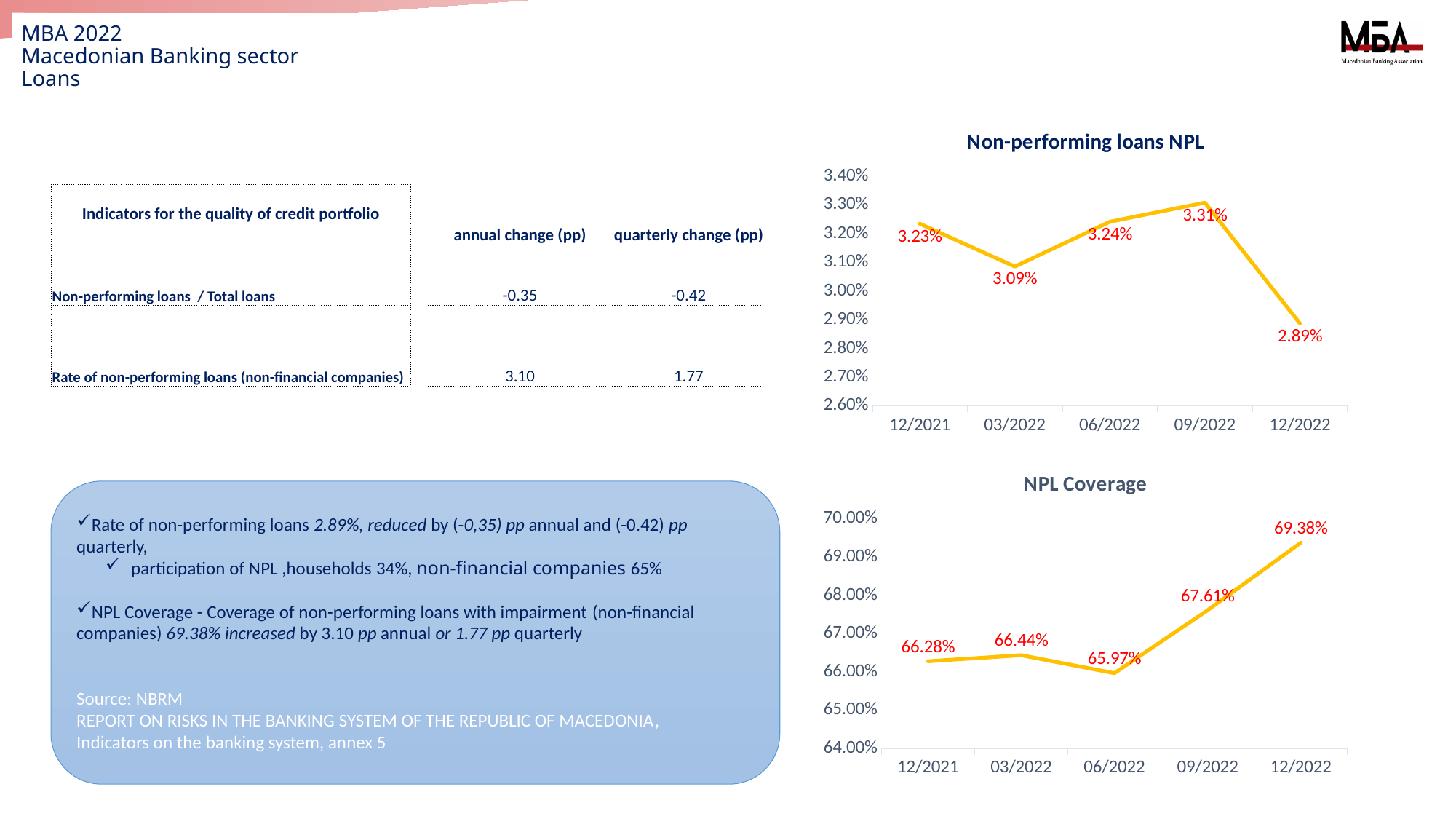
In the 'Non-performing loans NPL' chart, what is the value for 03/2022? 3.09% In the 'NPL Coverage' chart, what is the value for 09/2022? 67.61% In the 'Non-performing loans NPL' chart, how many data points are plotted? 5 In the 'Non-performing loans NPL' chart, what is the difference between the values for 09/2022 and 12/2022? 0.42 percentage points In the 'NPL Coverage' chart, what is the difference between the values for 12/2022 and 12/2021? 3.10 percentage points In the 'Non-performing loans NPL' chart, which period has the highest value? 09/2022 In the 'Non-performing loans NPL' chart, which period has the lowest value? 12/2022 What kind of chart is the 'NPL Coverage' chart? Line chart In the 'NPL Coverage' chart, which period has the lowest value? 06/2022 In the 'Non-performing loans NPL' chart, what is the value for 12/2022? 2.89% In the 'NPL Coverage' chart, which period has the highest value? 12/2022 In the 'NPL Coverage' chart, is the value for 12/2021 larger or smaller than the value for 03/2022? Smaller